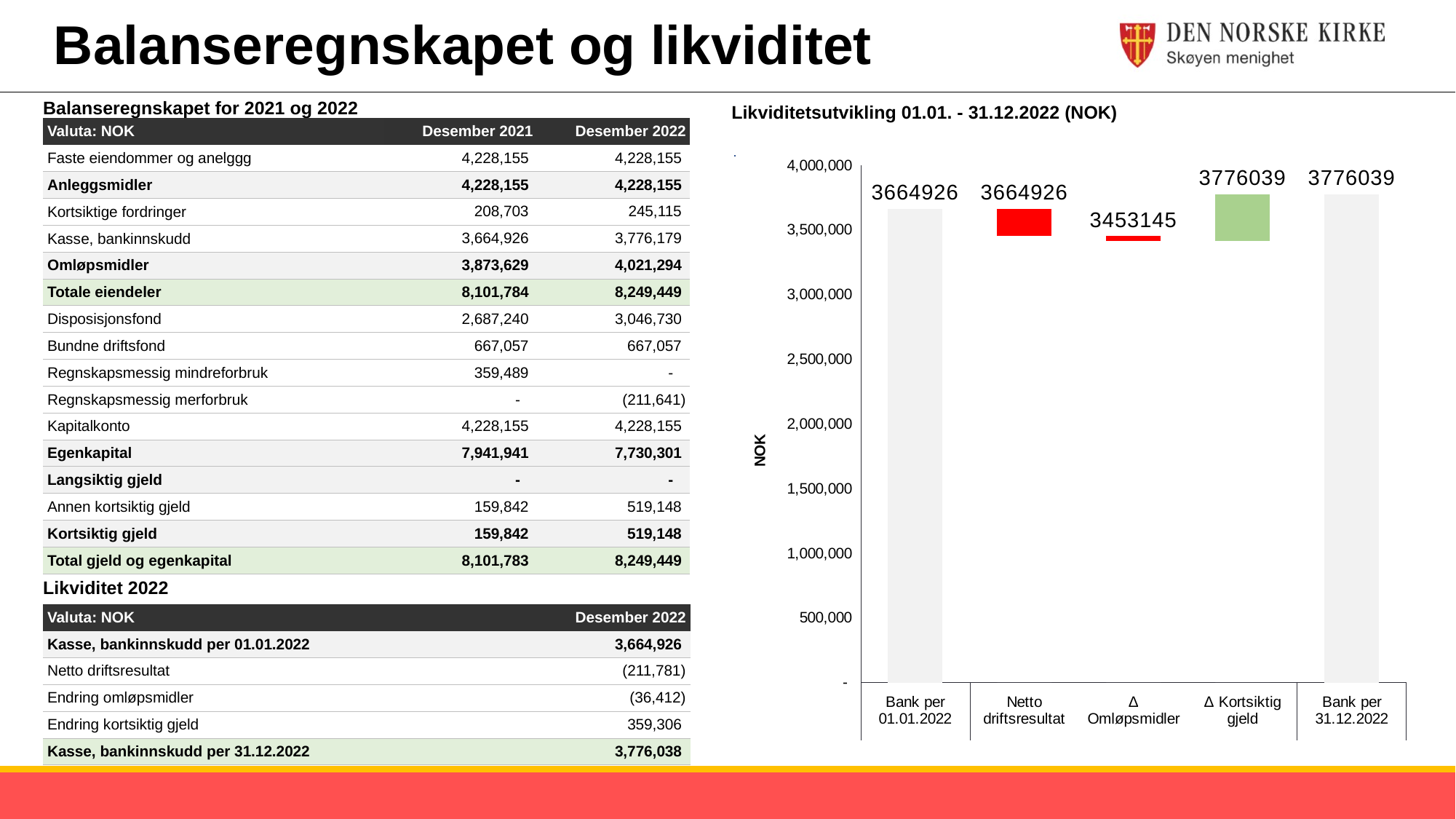
In the Likviditetsutvikling chart, what value is labelled above the Δ Kortsiktig gjeld bar? 3776039 What kind of chart is the Likviditetsutvikling chart? bar chart What is the title of the vertical axis in the Likviditetsutvikling chart? NOK In the Likviditetsutvikling chart, what is the difference between the labelled values for Bank per 31.12.2022 and Bank per 01.01.2022? 111113 In the Likviditetsutvikling chart, is the value for Bank per 01.01.2022 greater or less than 3,500,000? greater In the Likviditetsutvikling chart, what colour is the Δ Kortsiktig gjeld bar? green In the Likviditetsutvikling chart, which is larger: the value for Bank per 01.01.2022 or Bank per 31.12.2022? Bank per 31.12.2022 In the Likviditetsutvikling chart, what value is labelled for Bank per 01.01.2022? 3664926 In the Likviditetsutvikling chart, what value is labelled above the Δ Omløpsmidler bar? 3453145 In the Likviditetsutvikling chart, which category has the lowest labelled value? Δ Omløpsmidler How many categories are shown on the x axis of the Likviditetsutvikling chart? 5 In the Likviditetsutvikling chart, what value is labelled for Bank per 31.12.2022? 3776039